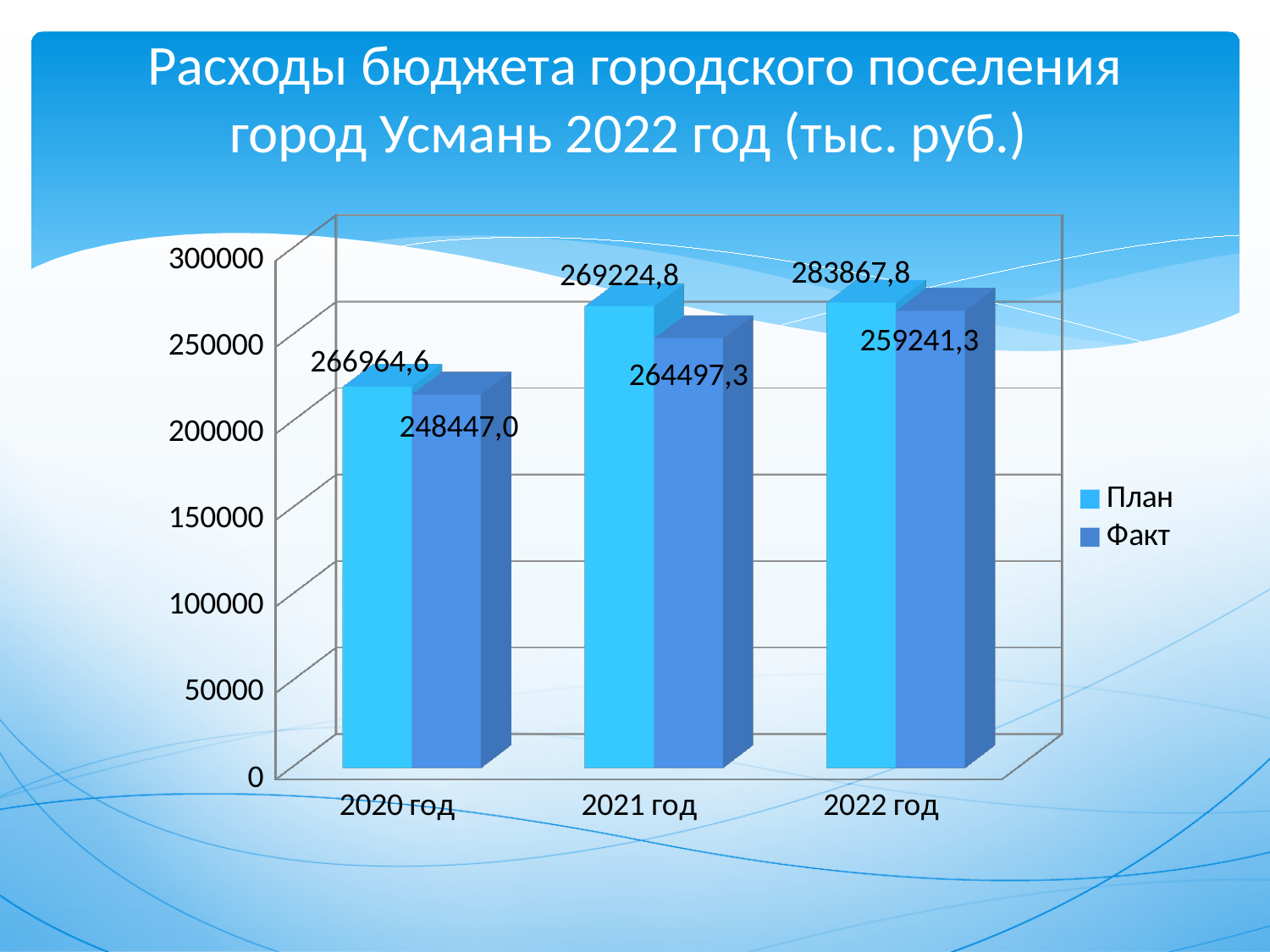
Which is larger for 2021 год, План or Факт? План How many series does the legend list? 2 What is the difference between План and Факт for 2022 год? 24626,5 What is the difference between План and Факт for 2020 год? 18517,6 What is the Факт value for 2021 год? 264497,3 Which year has the highest План value? 2022 год What is the Факт value for 2022 год? 259241,3 Do the План values rise or fall from 2020 год to 2022 год? Rise What kind of chart is shown on the slide? Bar chart What is the План value for 2020 год? 266964,6 Which year has the lowest Факт value? 2020 год How many years are shown on the x axis? 3